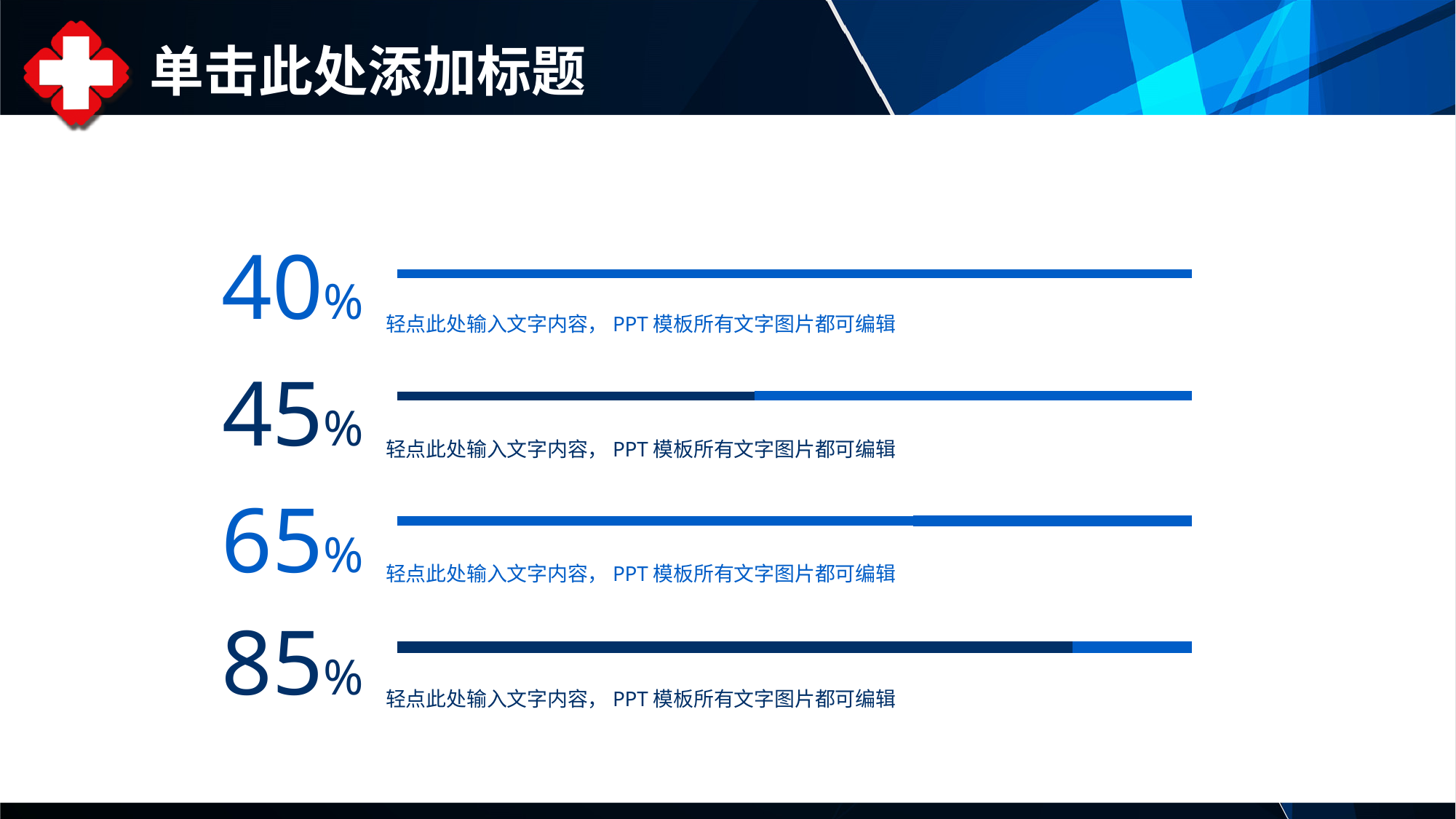
What is the difference between the bottom bar's percentage and the top bar's percentage? 45% What percentage is shown for the third bar from the top? 65% Which is larger, the percentage of the second bar or the third bar? The third bar (65%) What percentage is shown for the second bar from the top? 45% What percentage is shown for the fourth (bottom) bar? 85% What percentage is shown for the first (top) bar? 40% What is the difference between the third bar's percentage and the second bar's percentage? 20% How many percentage bars are shown on the slide? 4 Which bar has the lowest percentage? The first (top) bar, 40% What kind of chart is shown on the slide? Horizontal bar chart (progress bars) Which bar has the highest percentage? The fourth (bottom) bar, 85% Do the percentages increase or decrease going from the top bar to the bottom bar? Increase